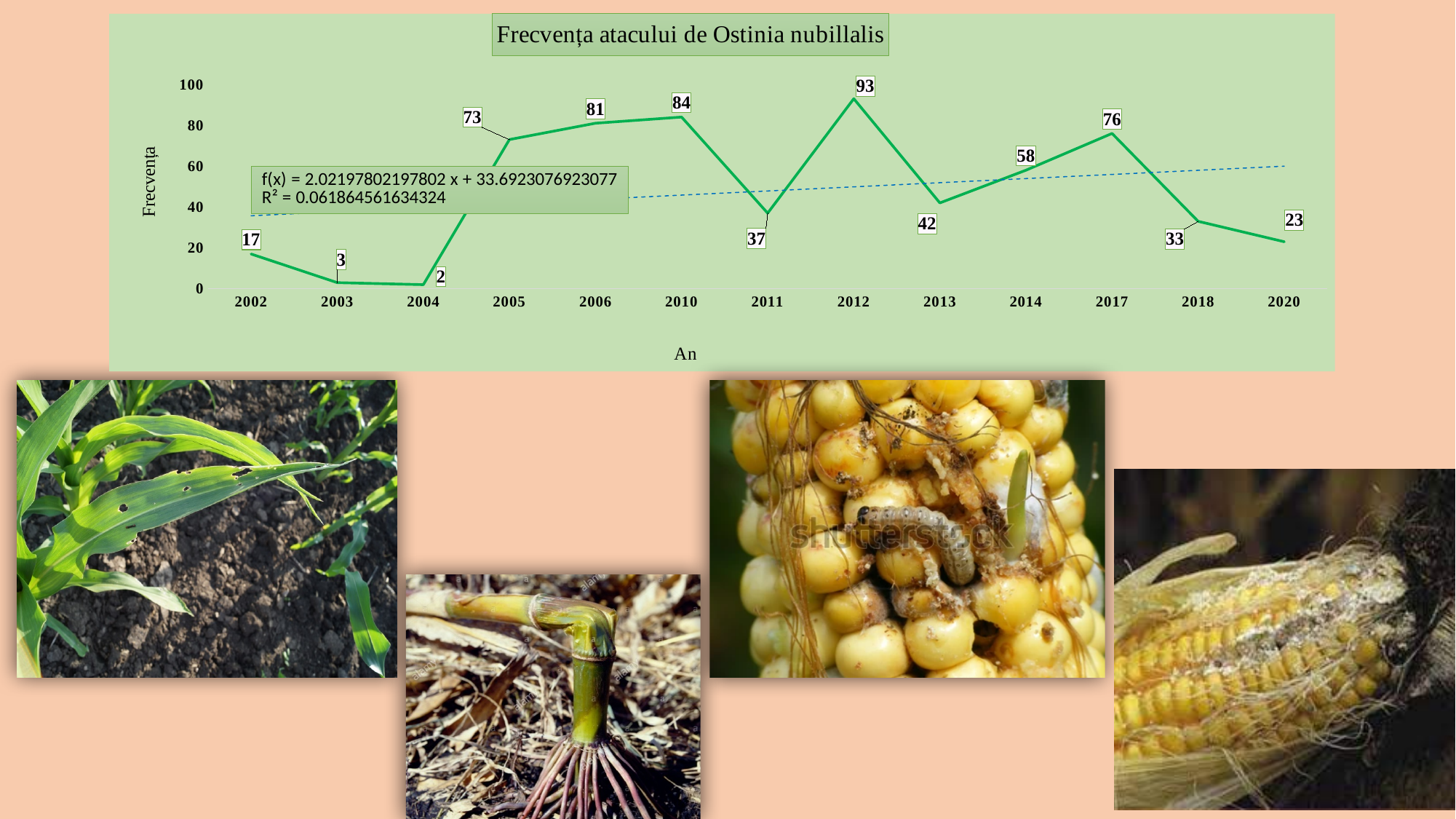
What is the difference between the values for 2010 and 2011? 47 Which is larger, the value for 2013 or the value for 2014? 2014 How many years are plotted on the x axis? 13 What is the title of the chart? Frecvența atacului de Ostinia nubillalis What is the value for 2004? 2 What is the value for 2017? 76 What kind of chart is shown? line chart Which year has the lowest value? 2004 What is the label of the x axis? An Which year has the highest value? 2012 What is the value for 2012? 93 Do the values rise or fall from 2017 to 2020? fall